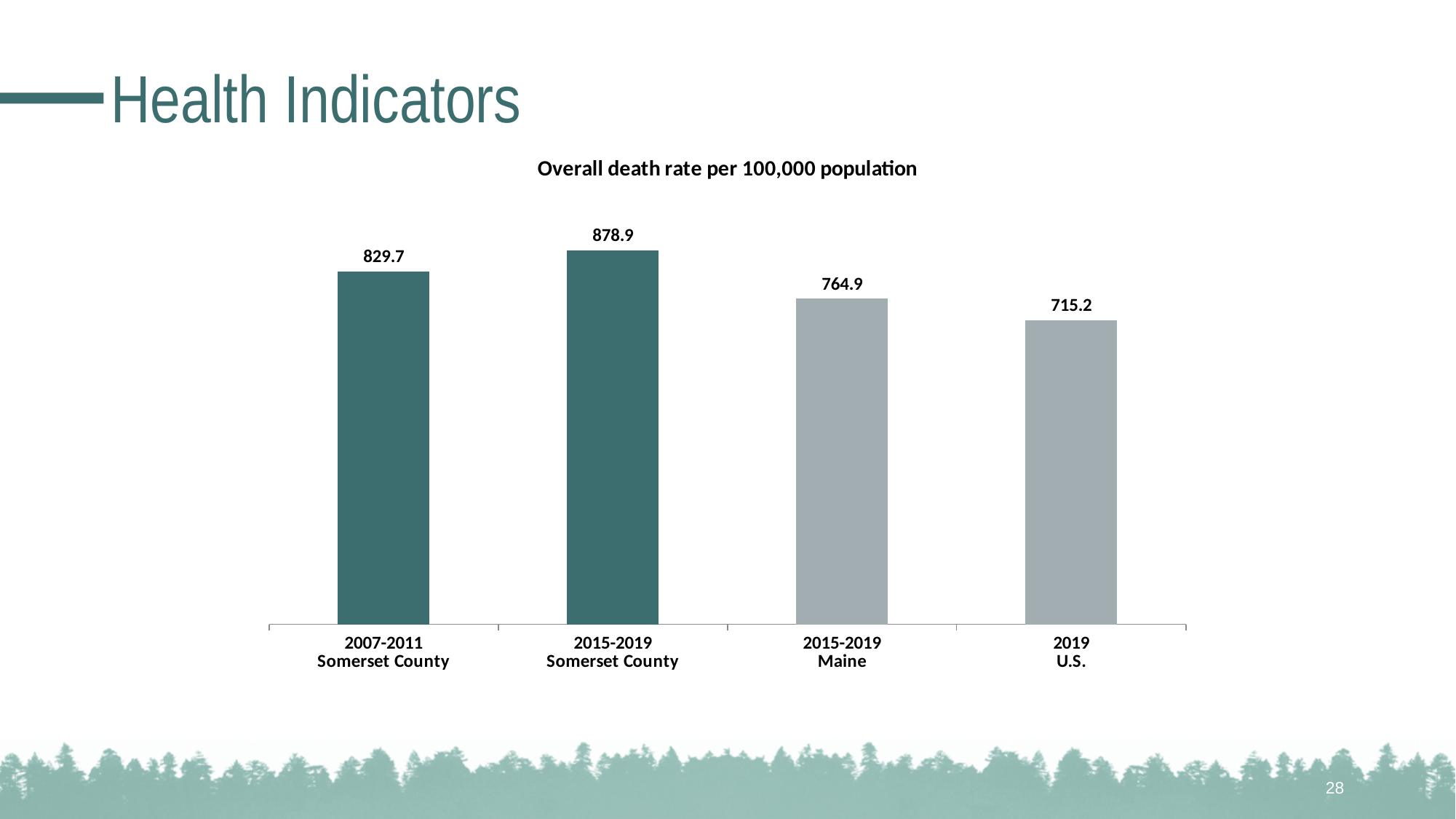
Which is larger, the 2015-2019 Maine death rate or the 2019 U.S. death rate? 2015-2019 Maine How many bars are shown in the chart? 4 What is the overall death rate per 100,000 population for Somerset County in 2007-2011? 829.7 What is the overall death rate per 100,000 population for Maine in 2015-2019? 764.9 What is the overall death rate per 100,000 population for the U.S. in 2019? 715.2 What is the title of the chart? Overall death rate per 100,000 population Which category has the highest overall death rate? 2015-2019 Somerset County What is the overall death rate per 100,000 population for Somerset County in 2015-2019? 878.9 What is the difference between the Somerset County death rate in 2015-2019 and in 2007-2011? 49.2 What kind of chart is shown on the slide? Bar chart What is the difference between the 2015-2019 Somerset County death rate and the 2015-2019 Maine death rate? 114.0 Which category has the lowest overall death rate? 2019 U.S.